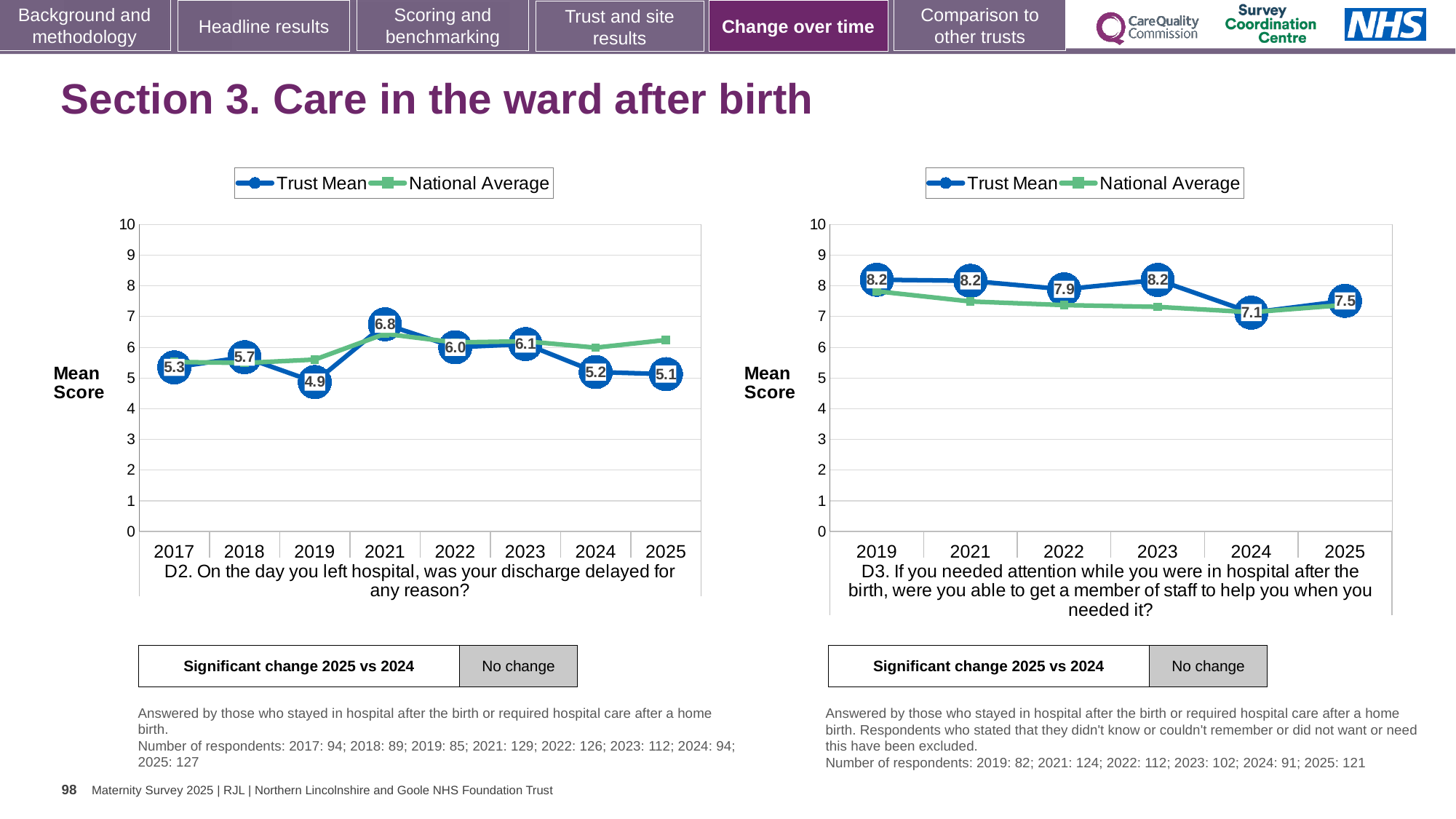
In the D2 chart on the left, what is the Trust Mean score for 2021? 6.8 In the D2 chart on the left, what is the difference between the Trust Mean scores for 2021 and 2025? 1.7 In the D3 chart on the right, what is the Trust Mean score for 2024? 7.1 In the D2 chart on the left, what is the Trust Mean score for 2019? 4.9 In the D2 chart on the left, which year has the highest Trust Mean score? 2021 In the D3 chart on the right, what is the Trust Mean score for 2025? 7.5 In the D2 chart on the left, which year has the lowest Trust Mean score? 2019 What type of chart is the D2 chart on the left? line chart How many years are plotted on the x axis of the D3 chart on the right? 6 In the D3 chart on the right, is the Trust Mean score for 2022 larger or smaller than the score for 2024? larger In the D3 chart on the right, which year has the lowest Trust Mean score? 2024 In the D2 chart on the left, is the National Average value for 2025 greater or less than 6? greater